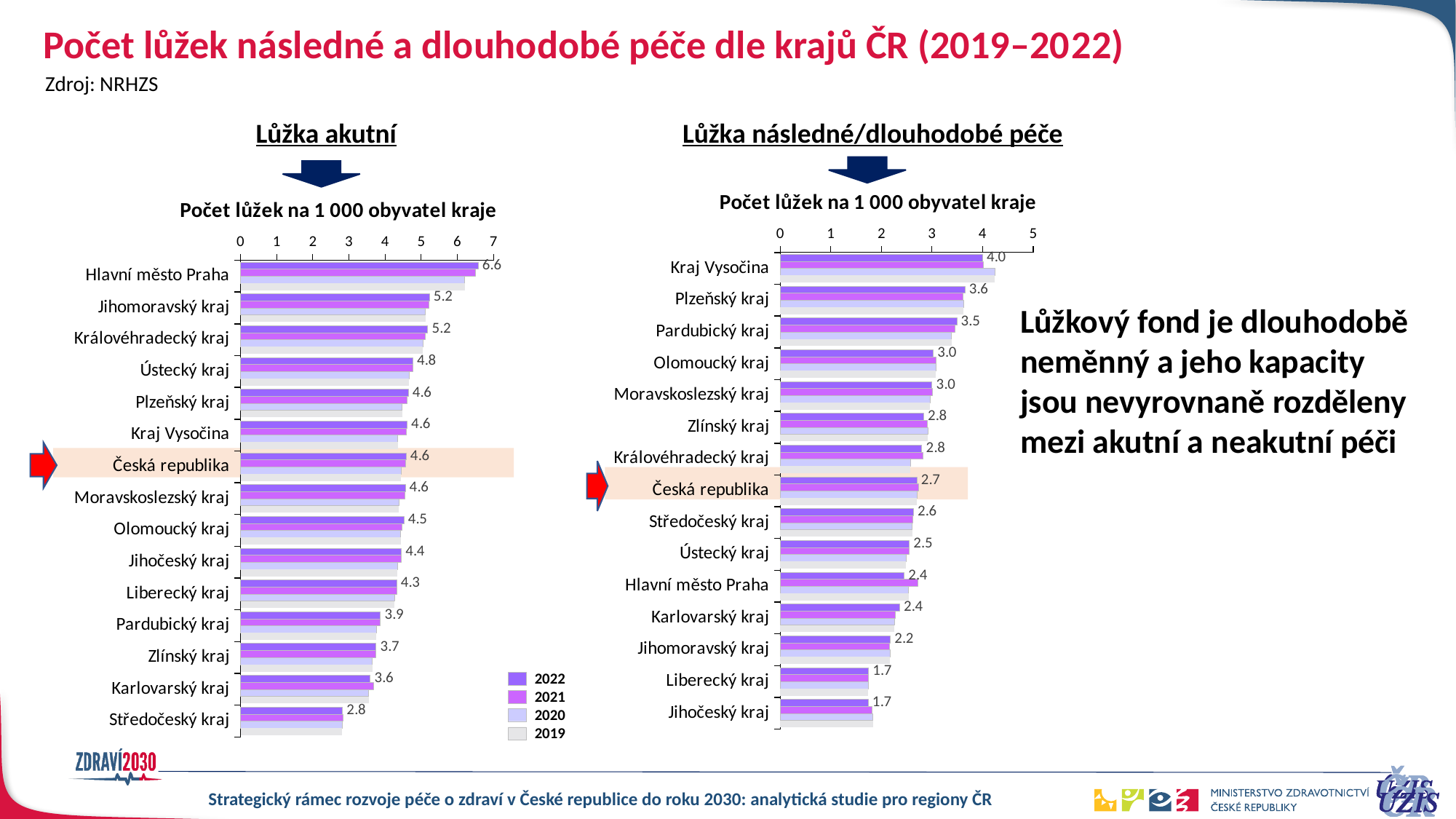
In the 'Lůžka akutní' chart, which category has the highest 2022 value? Hlavní město Praha In the 'Lůžka akutní' chart, what is the difference between the 2022 values for Ústecký kraj and Karlovarský kraj? 1.2 In the 'Lůžka následné/dlouhodobé péče' chart, what is the 2022 value for Česká republika? 2.7 In the 'Lůžka akutní' chart, what is the 2022 value for Hlavní město Praha? 6.6 In the 'Lůžka následné/dlouhodobé péče' chart, which category has the highest 2022 value? Kraj Vysočina How many categories are shown in the 'Lůžka akutní' chart? 15 In the 'Lůžka akutní' chart, which category has the lowest 2022 value? Středočeský kraj What kind of chart is the 'Lůžka následné/dlouhodobé péče' chart? Bar chart In the 'Lůžka následné/dlouhodobé péče' chart, which has the larger 2022 value, Plzeňský kraj or Jihomoravský kraj? Plzeňský kraj In the 'Lůžka akutní' chart, what is the difference between the 2022 values for Hlavní město Praha and Středočeský kraj? 3.8 How many series does the legend list? 4 In the 'Lůžka následné/dlouhodobé péče' chart, what is the 2022 value for Pardubický kraj? 3.5